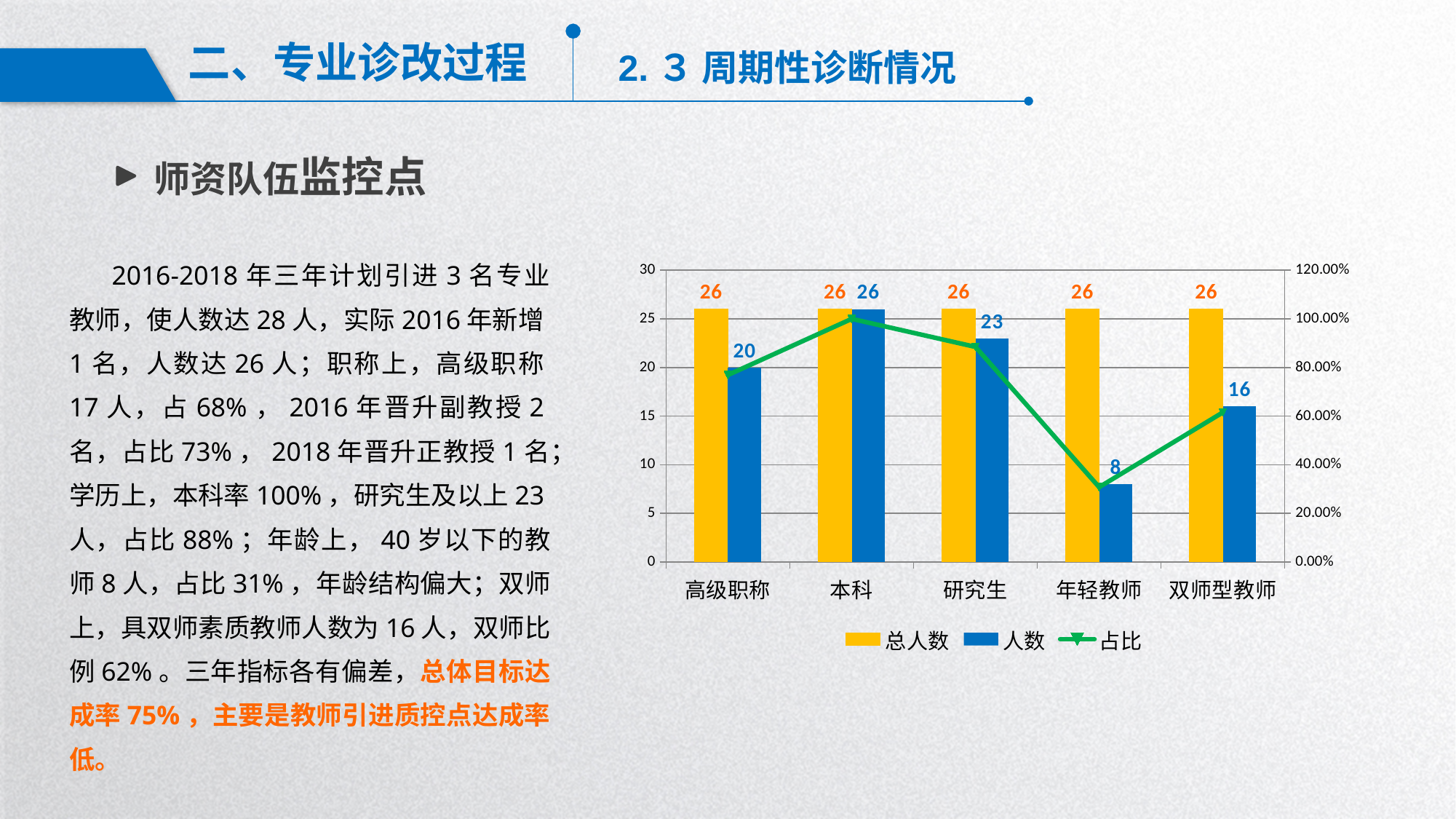
What is the value of 人数 for 年轻教师? 8 Which category has the highest 人数 value? 本科 Is the 占比 value for 年轻教师 greater or less than 40.00%? less Is the 占比 value for 本科 greater or less than 80.00%? greater What kind of chart is this? Bar chart with a line series What is the value of 总人数 for 双师型教师? 26 Which is larger, the 人数 value for 研究生 or for 双师型教师? 研究生 Which category has the lowest 人数 value? 年轻教师 How many series does the legend list? 3 How many categories are shown on the x axis? 5 What is the difference between 总人数 and 人数 for 高级职称? 6 What is the value of 人数 for 研究生? 23